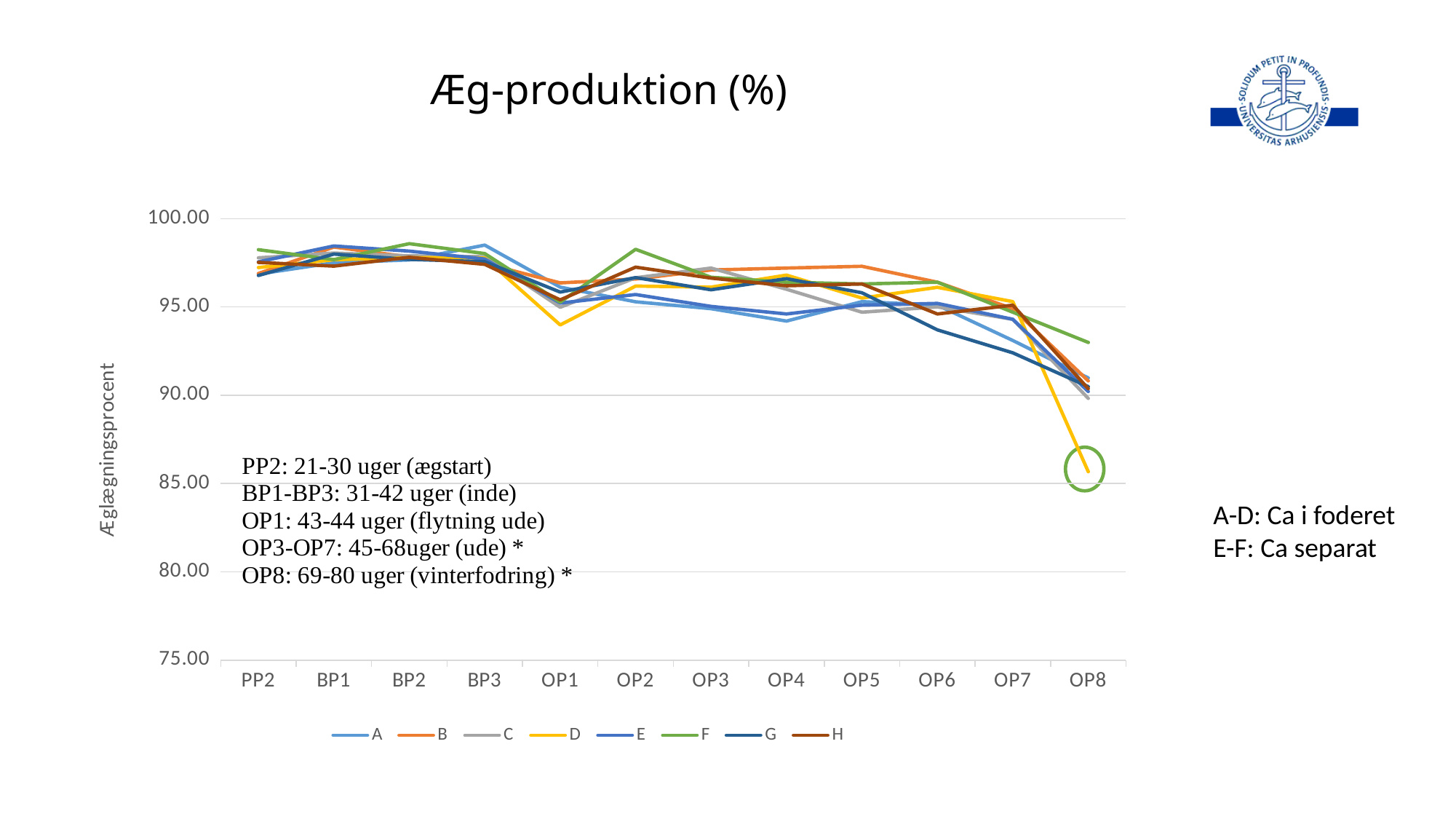
Which series has the lowest value at OP8? D Which series has the highest value at OP8? F Is the value for series F at OP2 greater or less than 95.00? greater How many series does the legend list? 8 Is the value for series G at OP6 greater or less than 95.00? less What kind of chart is shown on the slide? line chart Do the values generally rise or fall from PP2 to OP8? fall At OP6, which series has the larger value, B or G? B Is the value for series D at OP8 greater or less than 90.00? less What is the title of the chart? Æg-produktion (%) At OP8, which series has the larger value, F or D? F How many categories are shown on the x axis? 12